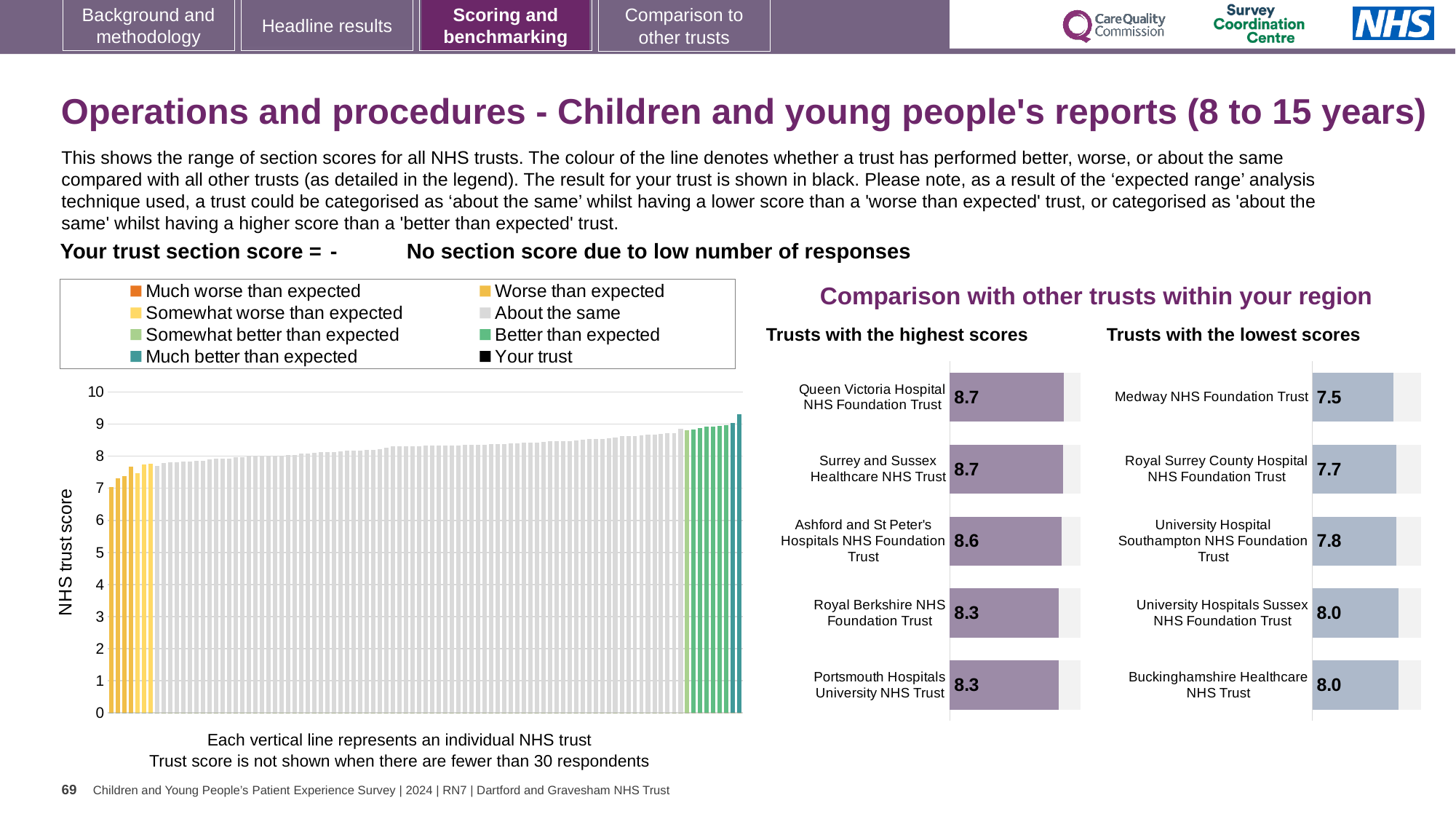
In the 'Trusts with the highest scores' chart, what is the score for Queen Victoria Hospital NHS Foundation Trust? 8.7 In the 'Trusts with the highest scores' chart, which has the higher score: Ashford and St Peter's Hospitals NHS Foundation Trust or Royal Berkshire NHS Foundation Trust? Ashford and St Peter's Hospitals NHS Foundation Trust In the 'Trusts with the lowest scores' chart, what is the difference between the scores of Buckinghamshire Healthcare NHS Trust and Medway NHS Foundation Trust? 0.5 In the 'NHS trust score' chart on the left, do the bar values rise or fall from left to right? Rise How many trusts are listed in the 'Trusts with the lowest scores' chart? 5 In the 'Trusts with the lowest scores' chart, what is the score for University Hospital Southampton NHS Foundation Trust? 7.8 In the 'Trusts with the lowest scores' chart, which trust has the lowest score? Medway NHS Foundation Trust What kind of chart is the 'NHS trust score' chart on the left of the slide? Bar chart In the 'Trusts with the highest scores' chart, what is the difference between the scores of Queen Victoria Hospital NHS Foundation Trust and Portsmouth Hospitals University NHS Trust? 0.4 How many entries does the legend above the 'NHS trust score' chart list? 8 In the 'NHS trust score' chart on the left, is the value of the leftmost bar greater or less than 8? less In the 'Trusts with the highest scores' chart, what is the score for Royal Berkshire NHS Foundation Trust? 8.3